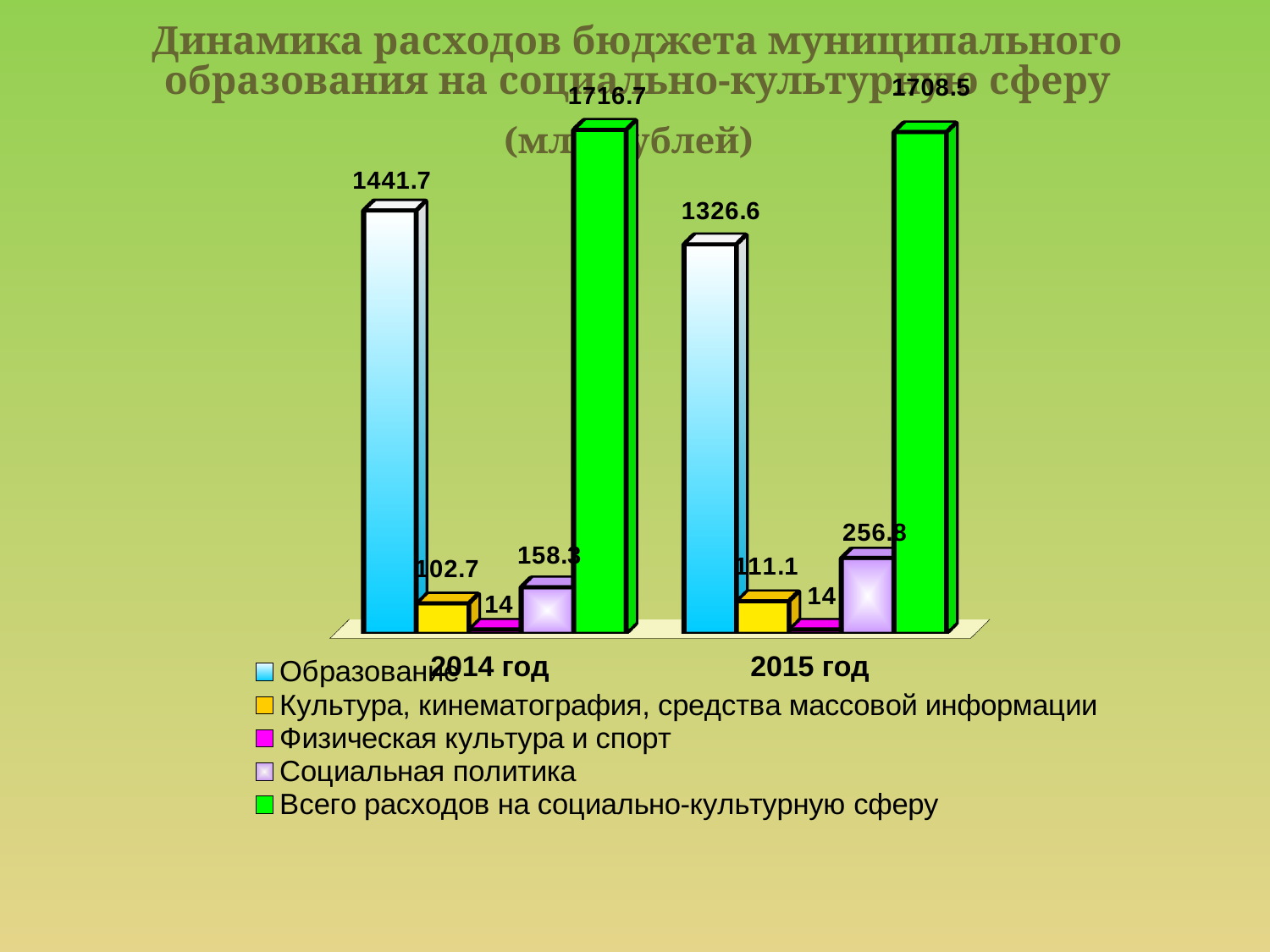
What is the value for Всего расходов на социально-культурную сферу in 2014 год? 1716.7 What is the value for Культура, кинематография, средства массовой информации in 2015 год? 111.1 What is the value for Образование in 2014 год? 1441.7 What is the difference between Всего расходов на социально-культурную сферу in 2014 год and in 2015 год? 8.2 Which series has the lowest value in 2014 год? Физическая культура и спорт By how much did the value for Образование decrease from 2014 год to 2015 год? 115.1 What is the value for Физическая культура и спорт in 2014 год? 14 Which year has the larger value for Культура, кинематография, средства массовой информации, 2014 год or 2015 год? 2015 год What kind of chart is shown on the slide? bar chart What is the value for Всего расходов на социально-культурную сферу in 2015 год? 1708.5 How many series does the legend list? 5 What is the value for Образование in 2015 год? 1326.6